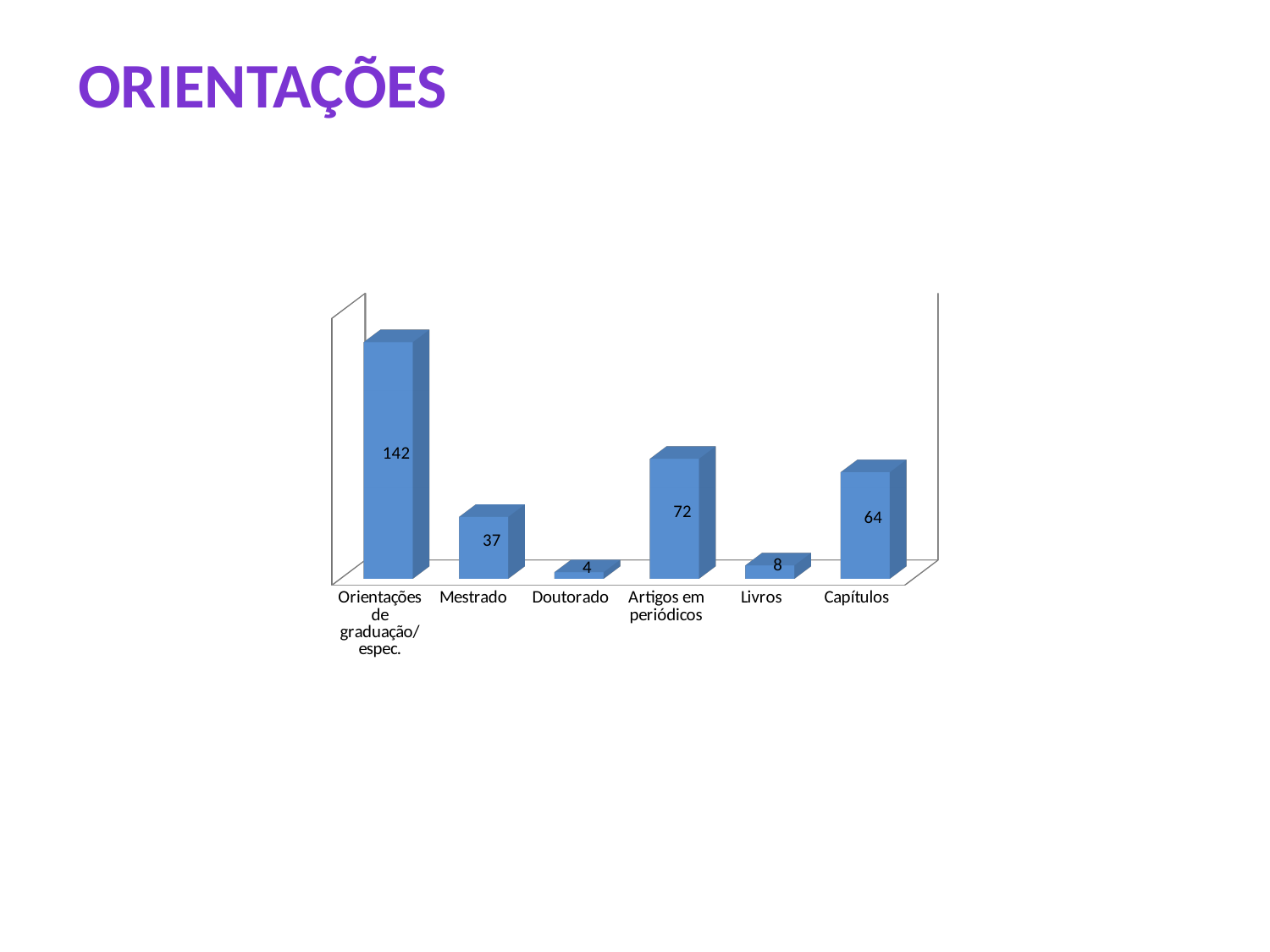
What is the value for Artigos em periódicos? 72 Which category has the lowest value? Doutorado What is the value for Livros? 8 Which is larger, the value for Mestrado or the value for Capítulos? Capítulos What is the value for Mestrado? 37 What kind of chart is shown on the slide? Bar chart What is the difference between the values for Orientações de graduação/espec. and Mestrado? 105 What is the value for Capítulos? 64 What is the difference between the values for Artigos em periódicos and Capítulos? 8 Which category has the highest value? Orientações de graduação/espec. How many categories are shown in the chart? 6 What is the title of the slide? ORIENTAÇÕES